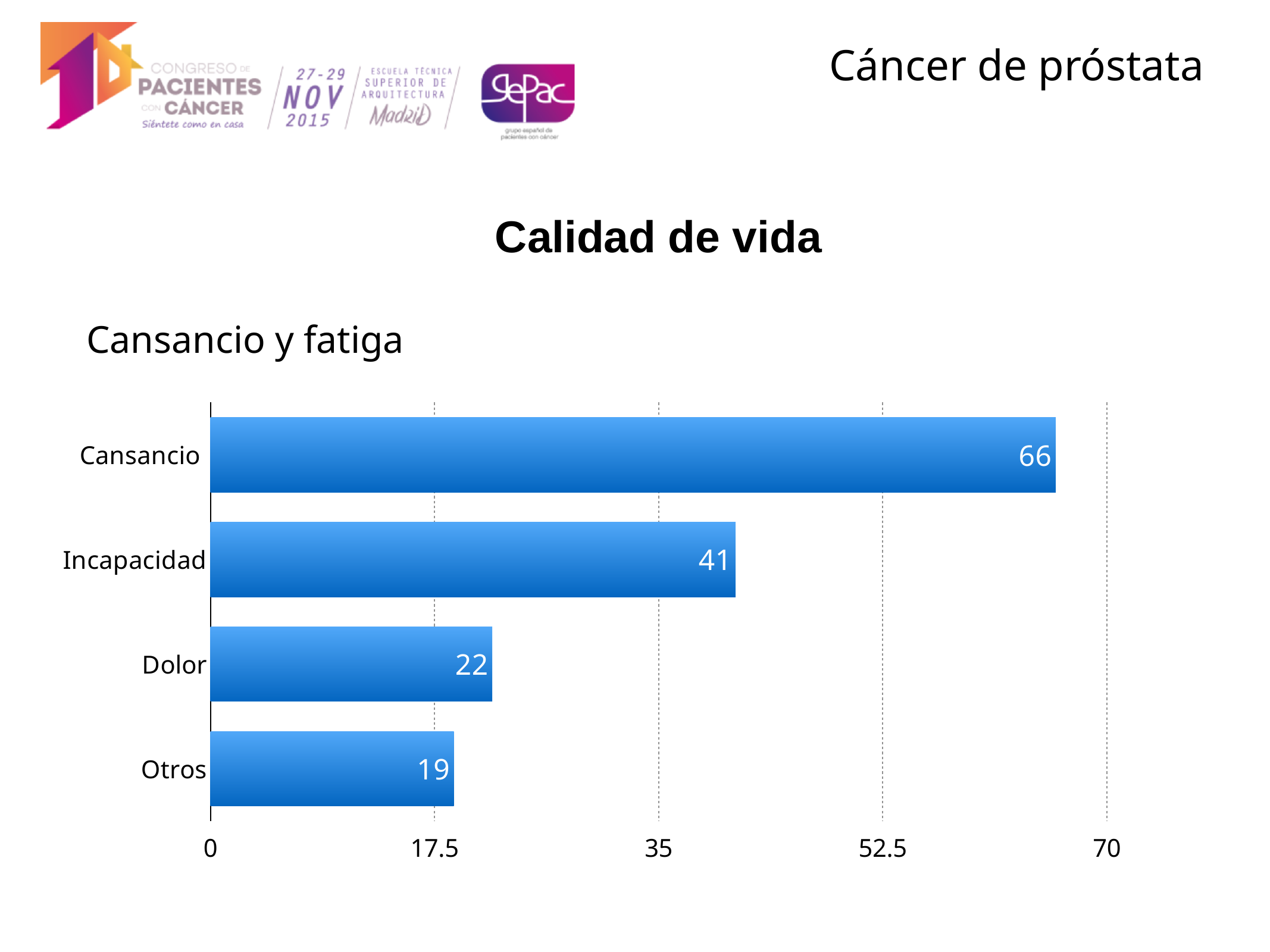
Is the value for Incapacidad greater or less than 35? greater What is the value for Otros? 19 Which is larger, the value for Incapacidad or the value for Dolor? Incapacidad Which category has the lowest value? Otros What is the value for Cansancio? 66 What is the value for Dolor? 22 How many categories are shown in the chart? 4 What is the difference between the values for Dolor and Otros? 3 Which category has the highest value? Cansancio What kind of chart is shown on the slide? Bar chart What is the value for Incapacidad? 41 What is the difference between the values for Cansancio and Incapacidad? 25